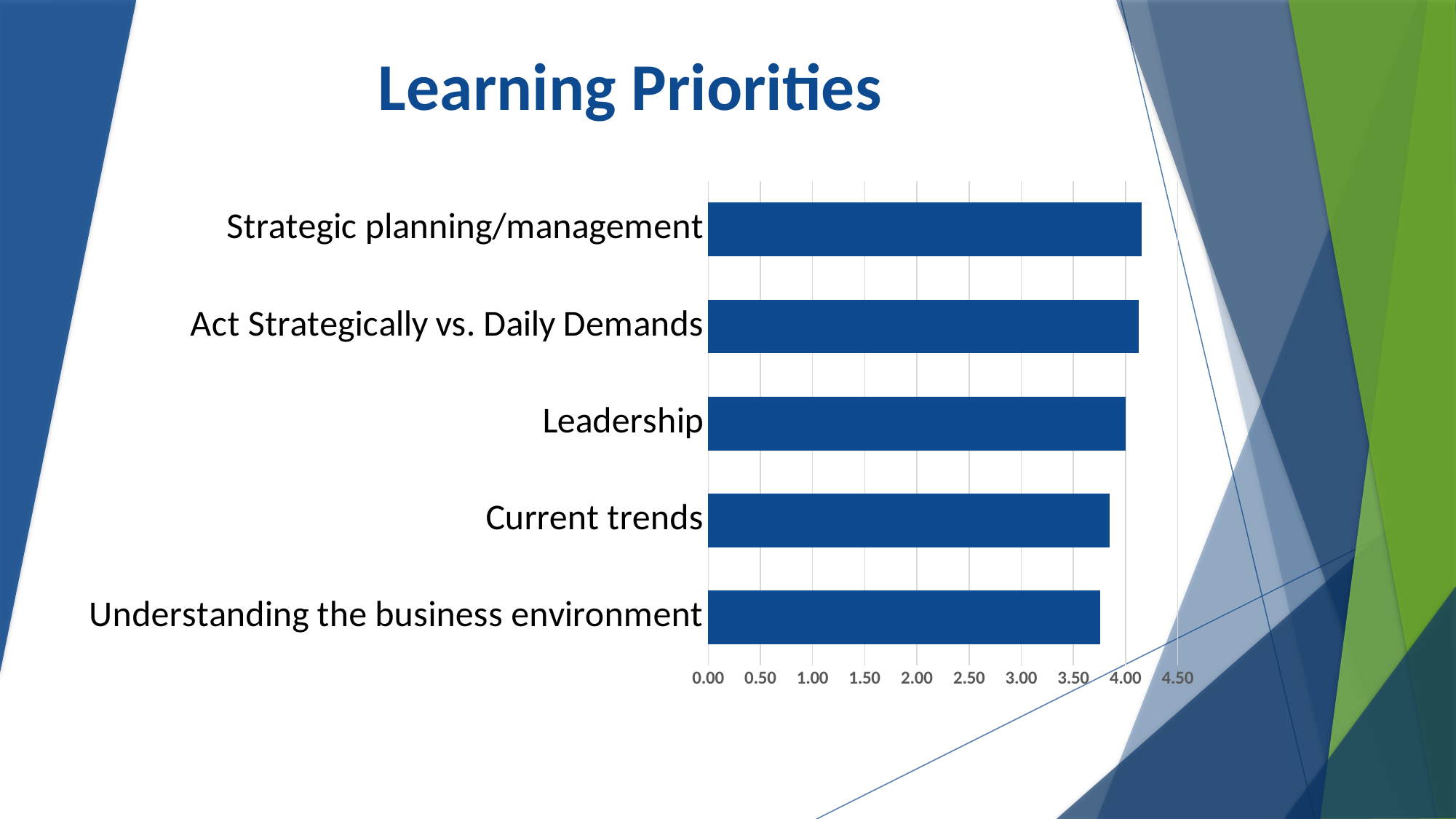
Is the value for Act Strategically vs. Daily Demands greater or less than 4.00? greater Which has the larger value, Leadership or Understanding the business environment? Leadership Is the value for Current trends greater or less than 4.00? less What is the title of the slide containing the chart? Learning Priorities How many categories are plotted in the chart? 5 Is the value for Understanding the business environment greater or less than 4.00? less What is the highest value shown on the chart's horizontal axis? 4.50 What kind of chart is shown on the slide? bar chart Which has the larger value, Strategic planning/management or Current trends? Strategic planning/management